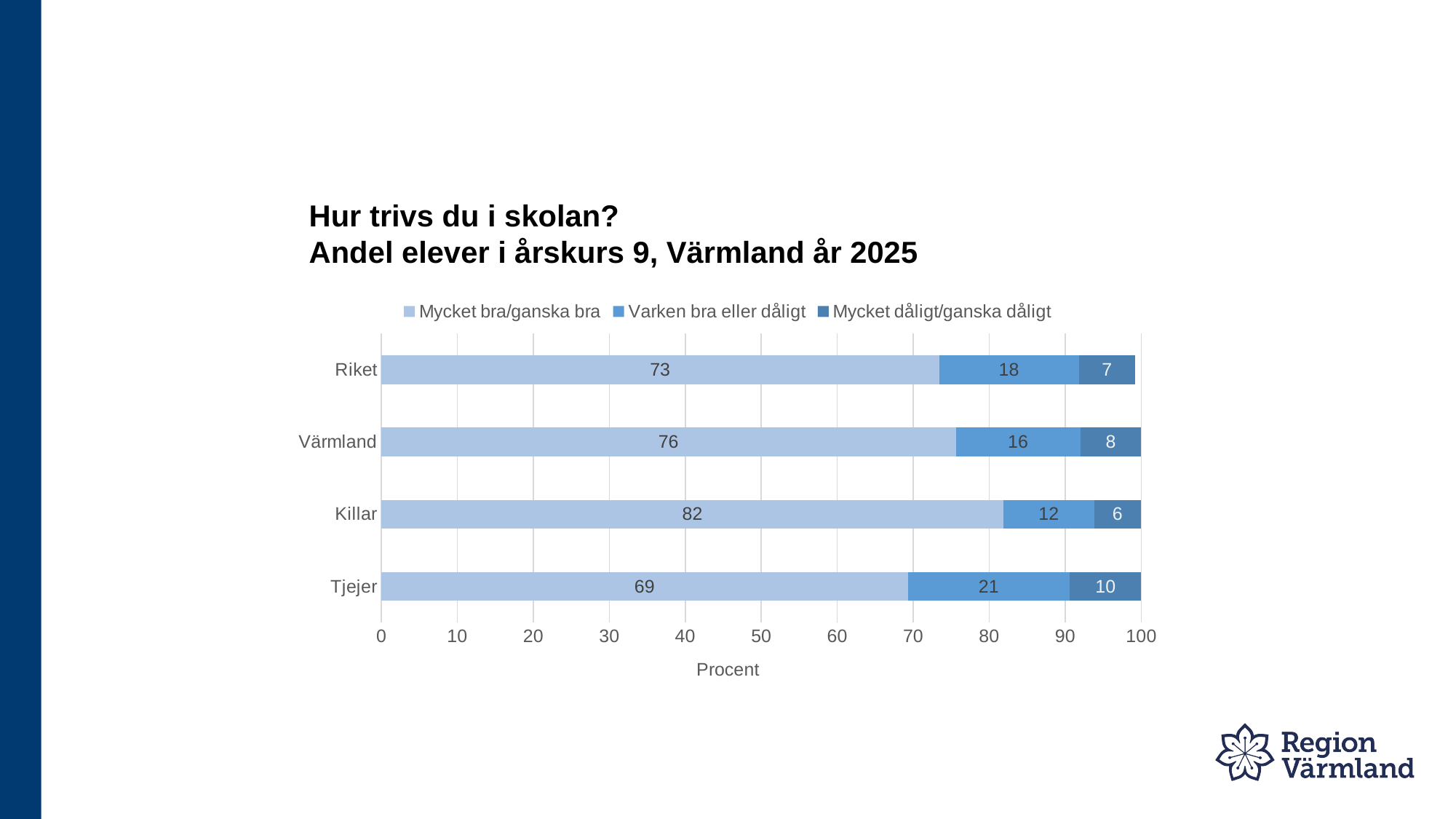
What is the label of the x axis? Procent Which category has the lowest value for 'Mycket dåligt/ganska dåligt'? Killar Which is larger: the 'Varken bra eller dåligt' value for Tjejer or for Värmland? Tjejer What kind of chart is shown on the slide? Stacked bar chart What is the value of 'Varken bra eller dåligt' for Riket? 18 What is the total of the stacked bar for Tjejer? 100 How many series does the legend list? 3 Which category has the highest value for 'Mycket bra/ganska bra'? Killar What is the value of 'Mycket dåligt/ganska dåligt' for Värmland? 8 What is the value of 'Mycket bra/ganska bra' for Tjejer? 69 What is the difference between the 'Mycket bra/ganska bra' values for Killar and Tjejer? 13 How many categories are shown on the y axis? 4